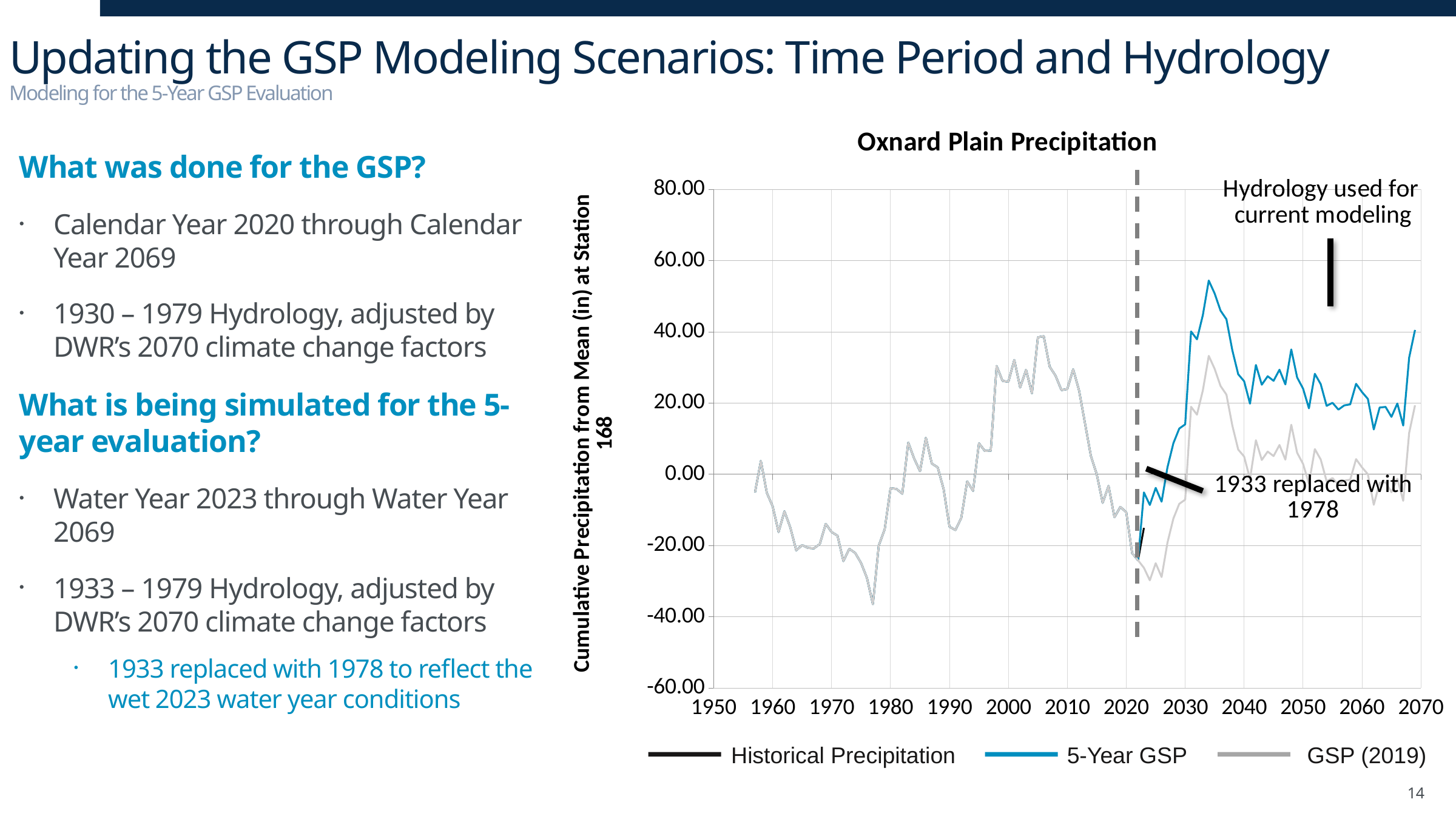
Is the Historical Precipitation value around 2020 greater or less than 0.00? less What kind of chart is shown on the slide? Line chart Is the peak value of the 5-Year GSP series (around 2035) greater or less than 40.00? greater How many year tick labels are shown on the horizontal axis? 13 Around 2050, which series has the higher value: 5-Year GSP or GSP (2019)? 5-Year GSP Does the 5-Year GSP series rise or fall between 2023 and 2035? Rise Is the peak value of the GSP (2019) series (around 2035) greater or less than 40.00? less What is the label on the vertical axis of the chart? Cumulative Precipitation from Mean (in) at Station 168 What is the title of the chart? Oxnard Plain Precipitation How many series does the chart legend list? 3